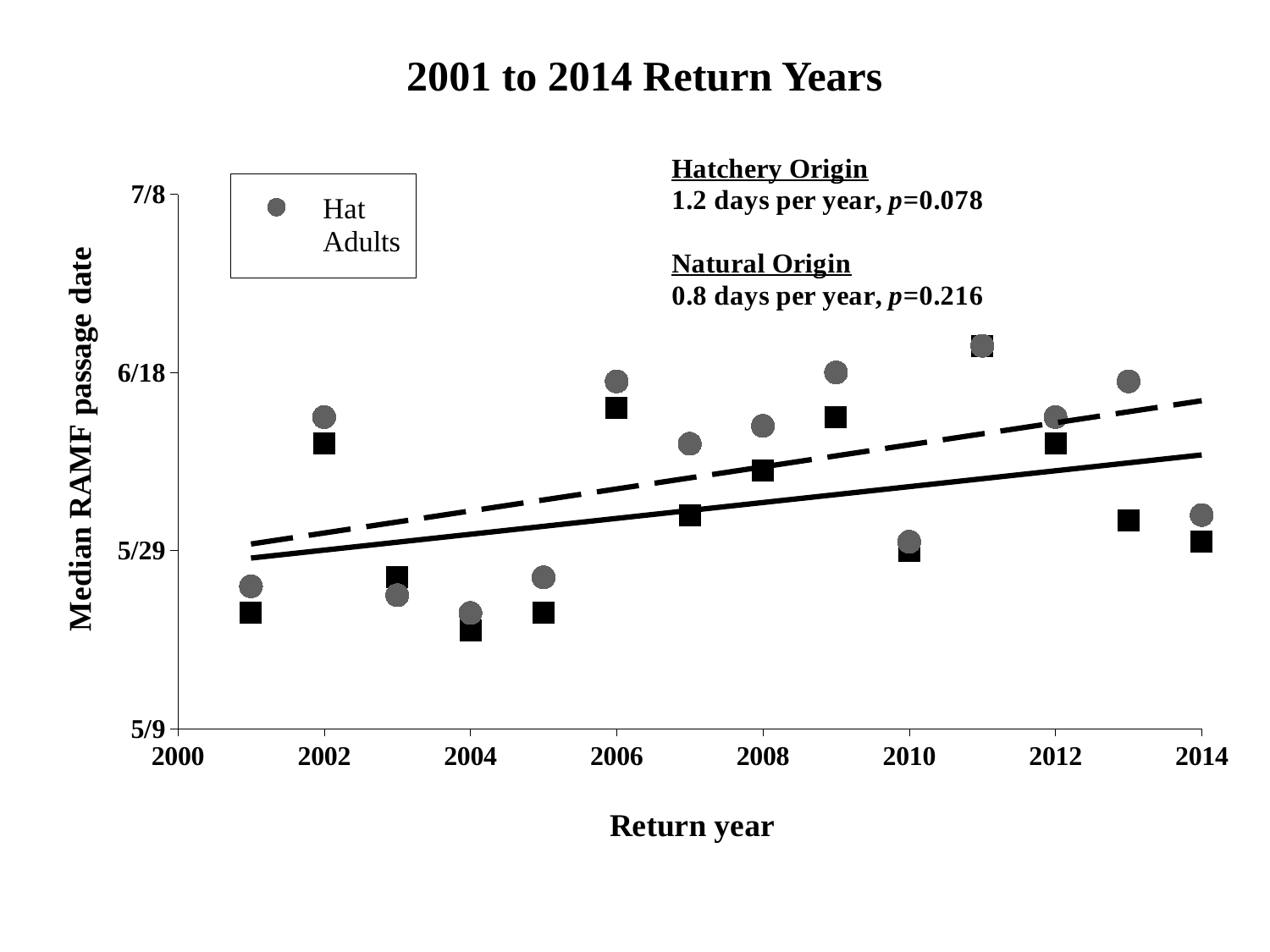
According to the annotation on the chart, what is the slope for Hatchery Origin? 1.2 days per year How many series does the chart's legend list? 1 What is the title of the chart? 2001 to 2014 Return Years How many return years are plotted for the Hat Adults series? 14 What kind of chart is shown on the slide? Scatter plot Which return year has a later Hat Adults median passage date, 2006 or 2010? 2006 In which return year is the Hat Adults median passage date the earliest (lowest point)? 2004 Do the fitted trend lines rise or fall as the return year increases? rise Is the Hat Adults value for 2004 greater or less than 5/29? less In which return year is the Hat Adults median passage date the latest (highest point)? 2011 Is the Hat Adults value for 2009 greater or less than 5/29? greater Is the Hat Adults value for 2011 greater or less than 6/18? greater